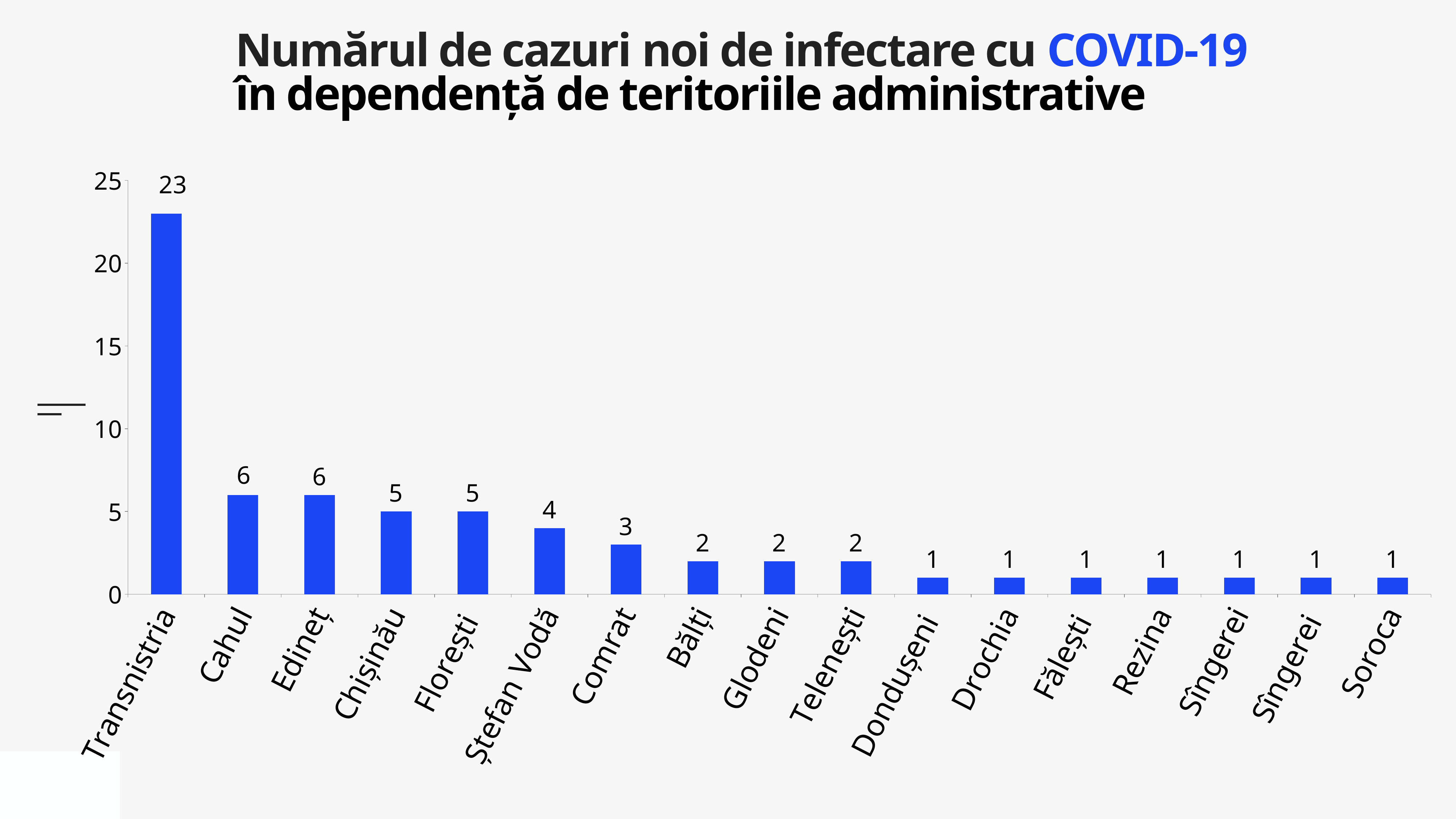
What is the difference between the values for Transnistria and Cahul? 17 Is the value for Transnistria greater or less than 20? greater What is the difference between the values for Florești and Bălți? 3 What is the value for Comrat? 3 Which territory has the highest number of new cases? Transnistria What is the value for Ștefan Vodă? 4 What is the value for Soroca? 1 What is the value for Chișinău? 5 How many bars are shown in the chart? 17 Which is larger, the value for Edineț or the value for Glodeni? Edineț What is the value for Transnistria? 23 What kind of chart is shown on the slide? bar chart